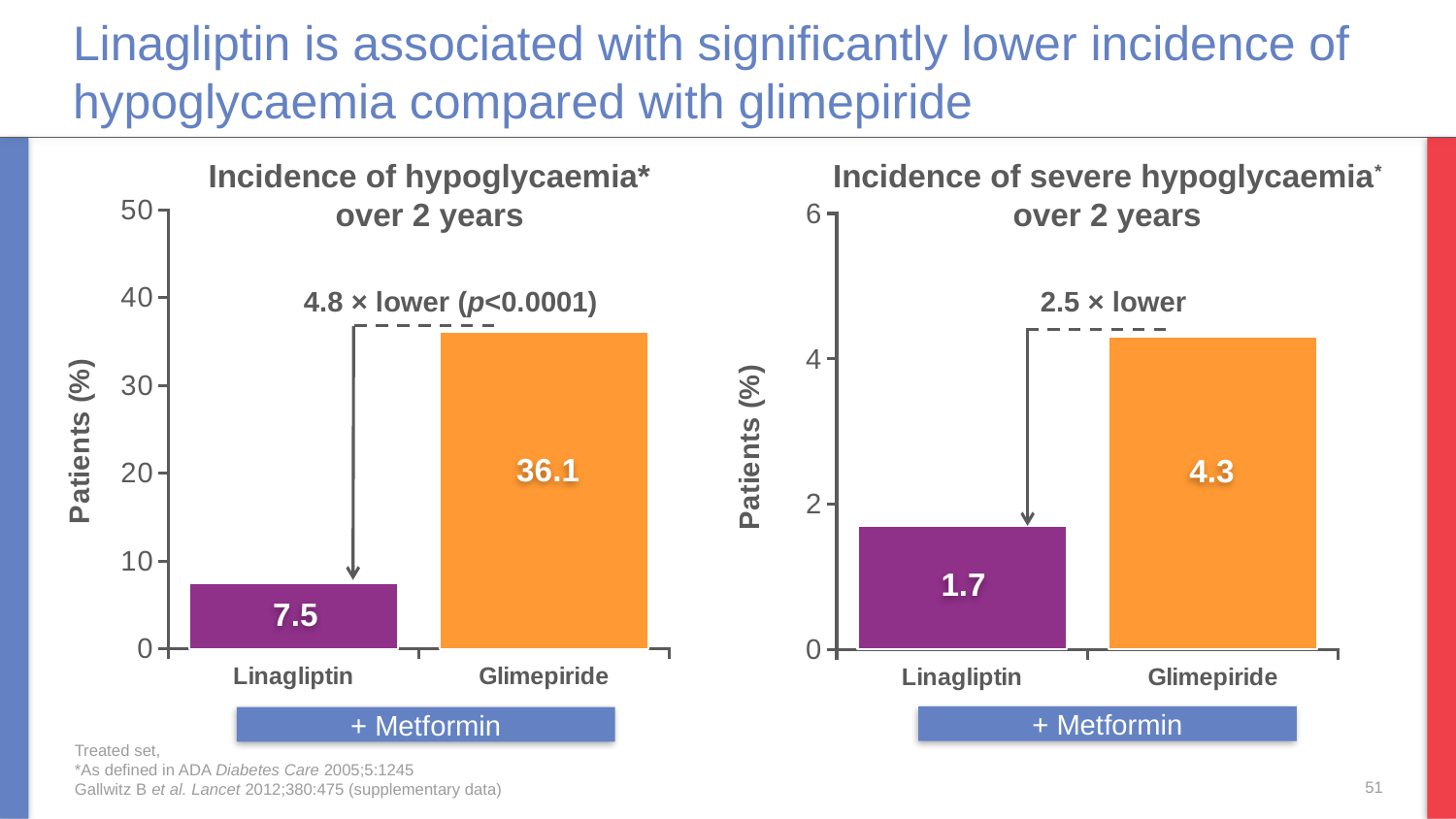
In the 'Incidence of hypoglycaemia over 2 years' chart, what is the value for Linagliptin? 7.5 What is the y-axis label of the 'Incidence of severe hypoglycaemia over 2 years' chart? Patients (%) In the 'Incidence of severe hypoglycaemia over 2 years' chart, what is the value for Glimepiride? 4.3 In the 'Incidence of severe hypoglycaemia over 2 years' chart, which category has the lowest value? Linagliptin In the 'Incidence of hypoglycaemia over 2 years' chart, which category has the highest value? Glimepiride In the 'Incidence of severe hypoglycaemia over 2 years' chart, what is the value for Linagliptin? 1.7 In the 'Incidence of hypoglycaemia over 2 years' chart, what is the value for Glimepiride? 36.1 What kind of chart is the 'Incidence of hypoglycaemia over 2 years' chart? Bar chart In the 'Incidence of hypoglycaemia over 2 years' chart, is the value for Glimepiride greater or less than 30? greater How many categories are shown in the 'Incidence of severe hypoglycaemia over 2 years' chart? 2 In the 'Incidence of severe hypoglycaemia over 2 years' chart, what is the difference between the Glimepiride and Linagliptin values? 2.6 In the 'Incidence of hypoglycaemia over 2 years' chart, what is the difference between the Glimepiride and Linagliptin values? 28.6